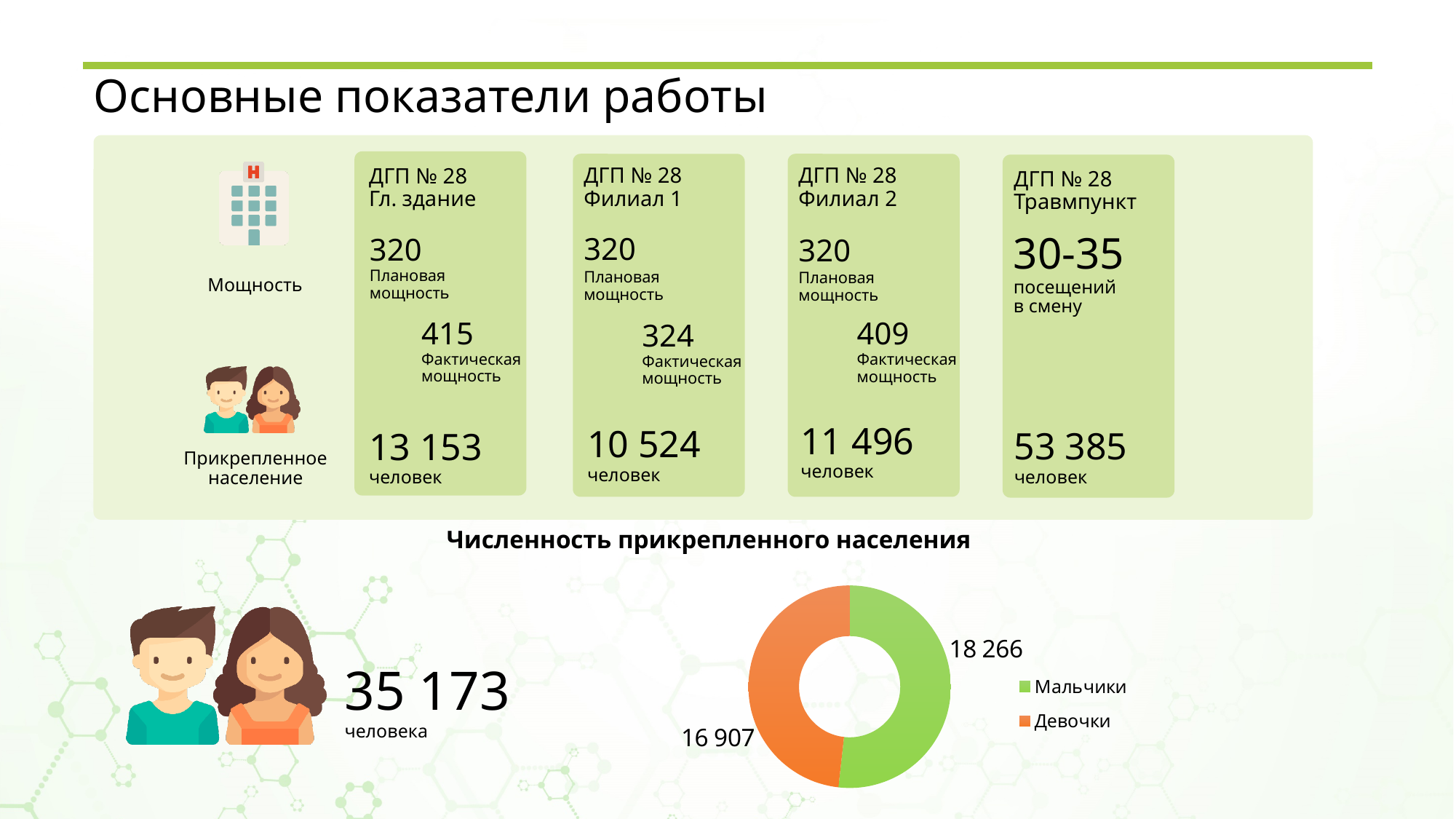
What colour represents Девочки in the pie chart? Orange What is the difference between the Мальчики and Девочки values in the pie chart? 1 359 How many entries does the legend of the pie chart list? 2 What kind of chart is shown under the heading «Численность прикрепленного населения»? Pie (donut) chart In the pie chart, what is the value for Мальчики? 18 266 How many slices does the pie chart have? 2 Which slice of the pie chart is the smallest? Девочки What is the title of the pie chart? Численность прикрепленного населения In the pie chart, what is the value for Девочки? 16 907 What is the total of the two slices in the pie chart? 35 173 Which slice of the pie chart is the largest? Мальчики In the pie chart, which is larger: Мальчики or Девочки? Мальчики